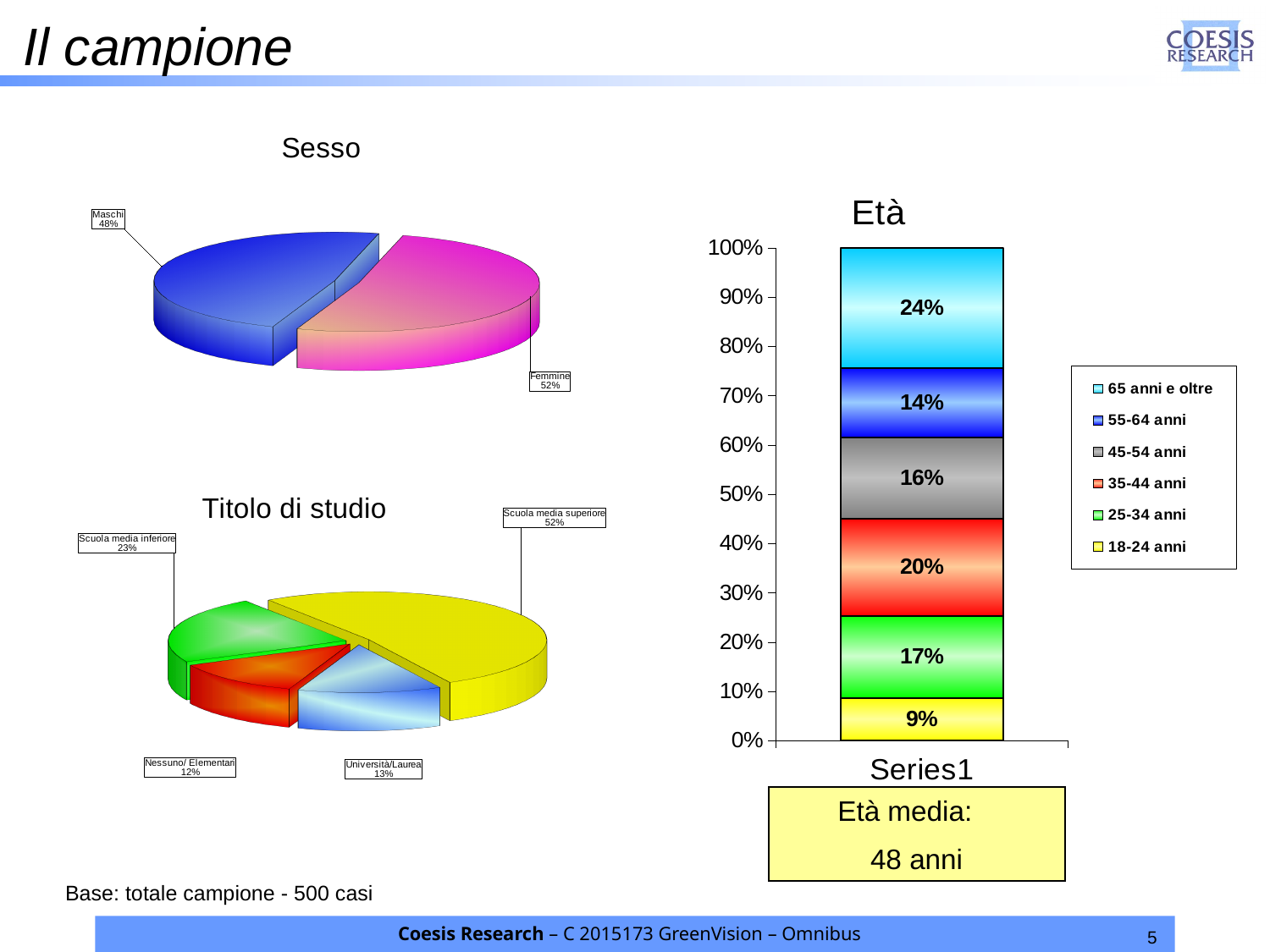
In the "Titolo di studio" chart, what is the difference between Scuola media superiore and Scuola media inferiore? 29 percentage points In the "Età" chart, which is larger: 25-34 anni or 45-54 anni? 25-34 anni What kind of chart is the "Sesso" chart? Pie chart In the "Età" chart, which age group has the highest value? 65 anni e oltre In the "Titolo di studio" chart, what is the value for Università/Laurea? 13% In the "Titolo di studio" chart, which category has the largest share? Scuola media superiore In the "Età" chart, what is the value for 35-44 anni? 20% How many categories does the "Titolo di studio" chart show? 4 In the "Sesso" chart, what is the value for Femmine? 52% In the "Titolo di studio" chart, which category has the smallest share? Nessuno/ Elementari In the "Sesso" chart, what is the value for Maschi? 48% How many series does the legend of the "Età" chart list? 6